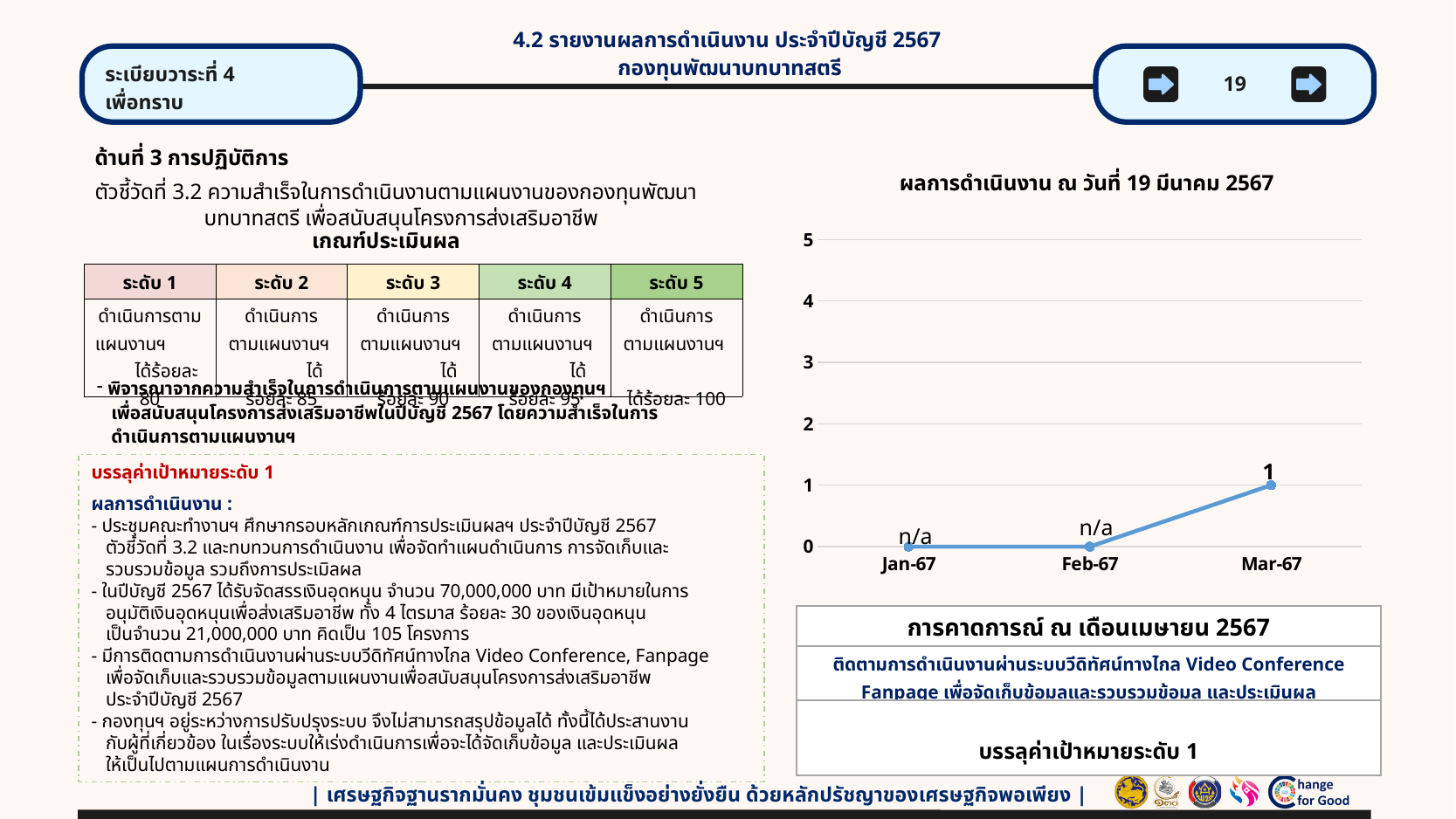
Is the value for Mar-67 greater or less than 2? less Does the line rise or fall from Feb-67 to Mar-67? rise What is the data label shown for Jan-67? n/a How many points are plotted along the x axis of the chart? 3 Which month has the highest plotted value? Mar-67 What is the first month label on the x axis? Jan-67 What is the data label shown for Feb-67? n/a What is the title of the chart? ผลการดำเนินงาน ณ วันที่ 19 มีนาคม 2567 What kind of chart is shown on the slide? line chart What is the highest value shown on the y axis? 5 What is the data label shown for Mar-67? 1